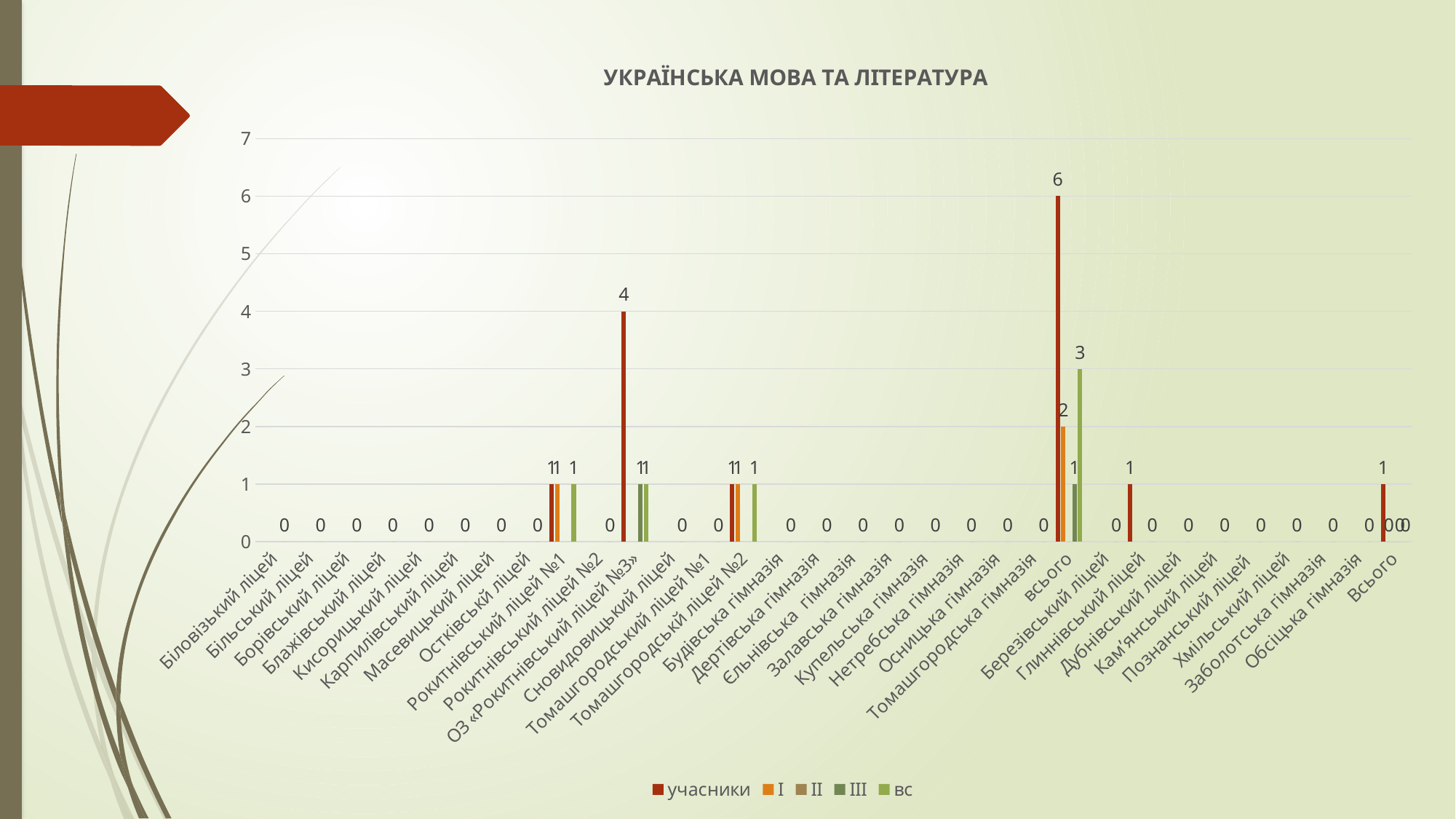
Which category has the highest value for учасники? всього What is the value of учасники for всього? 6 What is the value of I for всього? 2 Which has a larger учасники value: ОЗ «Рокитнівський ліцей №3» or Глиннівський ліцей? ОЗ «Рокитнівський ліцей №3» What is the title of the chart? УКРАЇНСЬКА МОВА ТА ЛІТЕРАТУРА What kind of chart is shown on the slide? bar chart What is the difference between the учасники value for всього and for ОЗ «Рокитнівський ліцей №3»? 2 What is the value of учасники for Глиннівський ліцей? 1 How many series does the legend list? 5 What is the value of вс for всього? 3 What is the value of учасники for ОЗ «Рокитнівський ліцей №3»? 4 Is the учасники value for всього greater or less than 5? greater